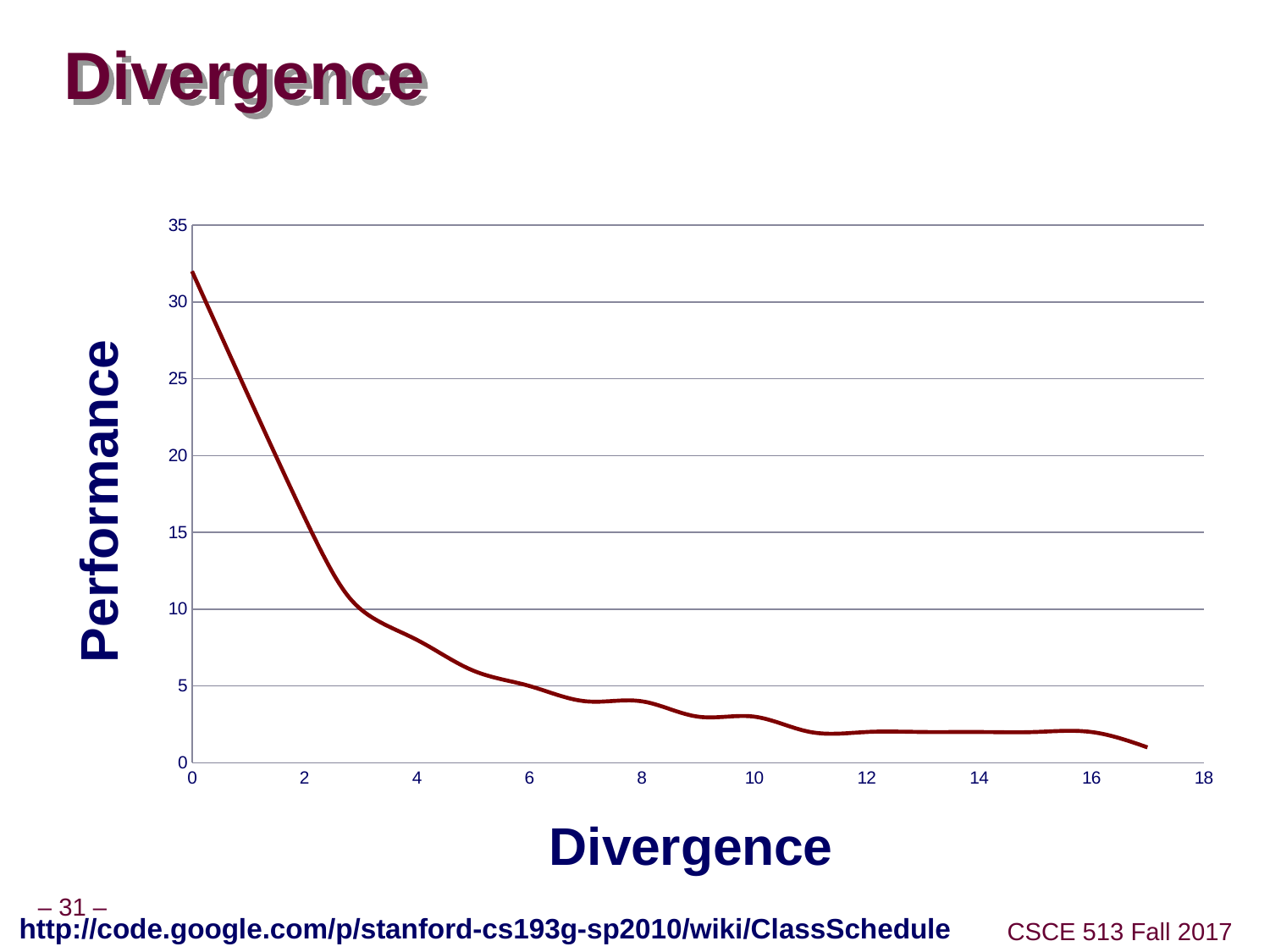
What kind of chart is shown on the slide? line chart What is the label of the y axis? Performance Is the performance value at divergence 4 greater or less than 10? less Is the performance value at divergence 8 greater or less than 5? less Which is larger, the performance at divergence 0 or at divergence 16? divergence 0 Is the performance value at divergence 0 greater or less than 30? greater Does performance rise or fall as divergence increases along the x axis? fall What is the label of the x axis? Divergence At which divergence value is performance highest? 0